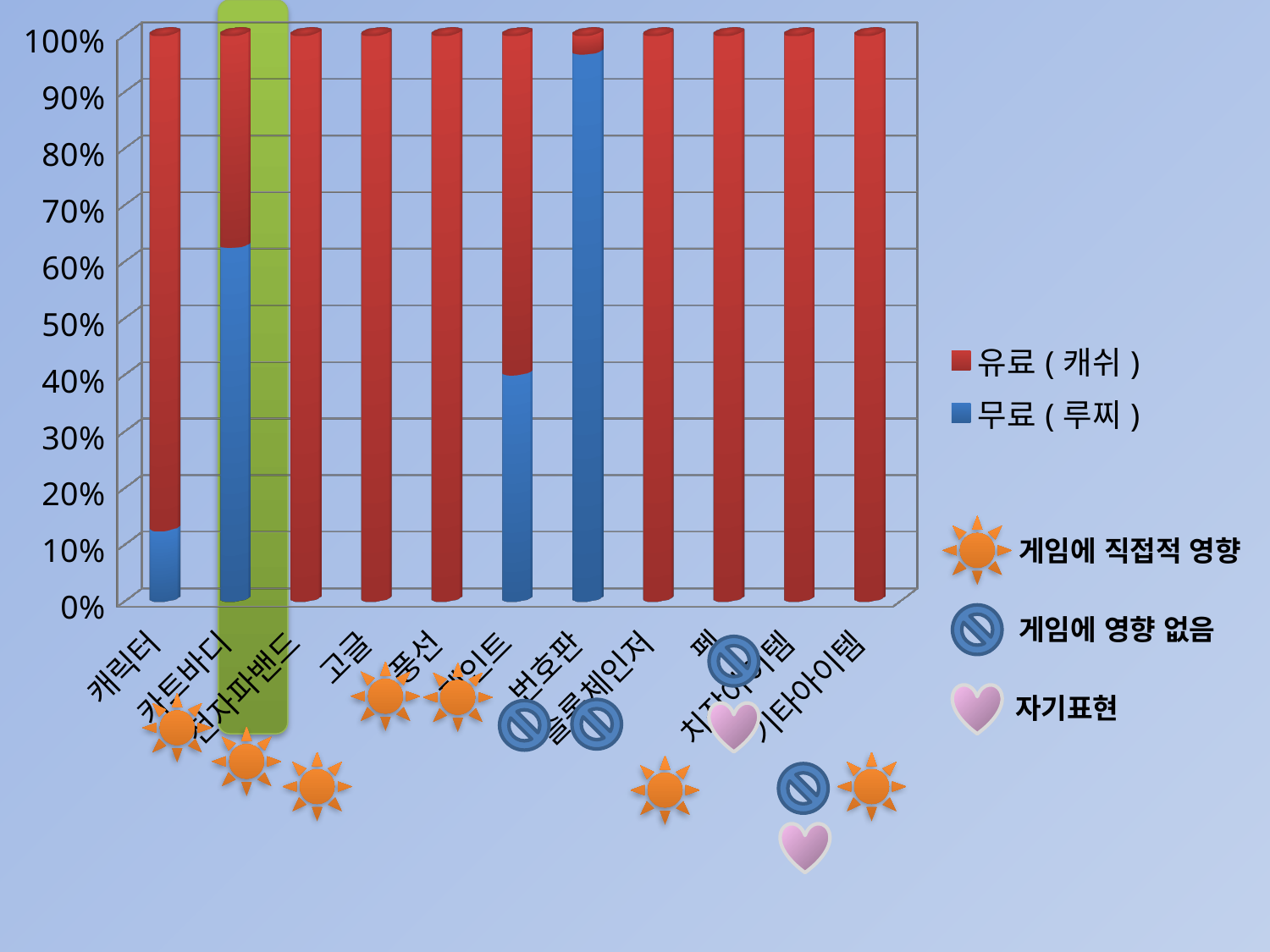
Is the 유료 ( 캐쉬 ) share for 번호판 greater or less than 10%? less Is the 무료 ( 루찌 ) share for 카트바디 greater or less than 50%? greater Which category has the smallest 유료 ( 캐쉬 ) share? 번호판 Which category has the largest 무료 ( 루찌 ) share? 번호판 What kind of chart is shown on the slide? stacked bar chart What is the total height of the stacked bar for 고글? 100% Which colour represents the 유료 ( 캐쉬 ) series? red What are the two series named in the legend? 유료 ( 캐쉬 ) and 무료 ( 루찌 ) How many categories (bars) are plotted on the x axis? 11 Which has a larger 무료 ( 루찌 ) share, 카트바디 or 캐릭터? 카트바디 Is the 무료 ( 루찌 ) share for 캐릭터 greater or less than 20%? less How many series does the legend list? 2